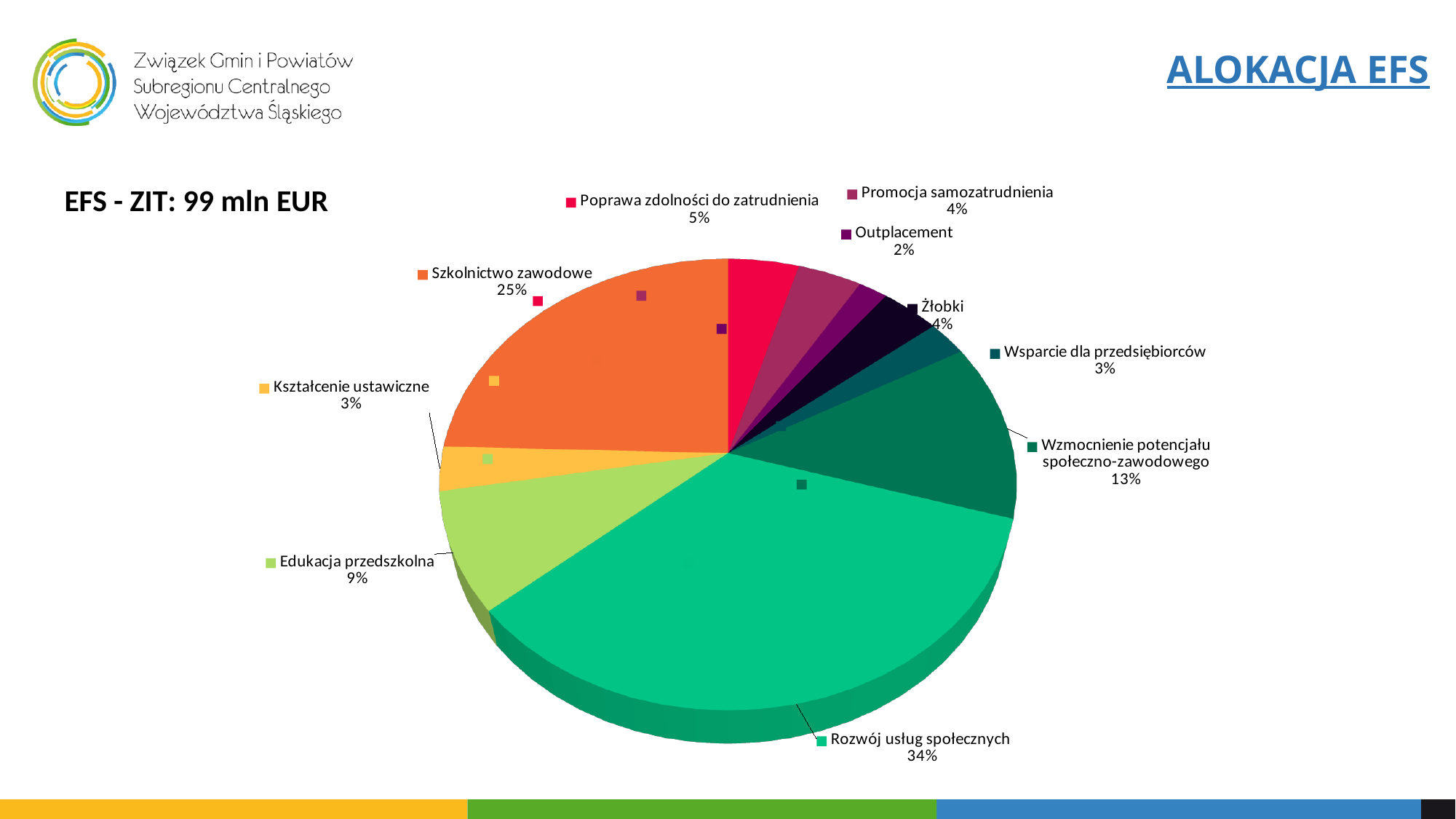
What percentage is shown for Wzmocnienie potencjału społeczno-zawodowego? 13% How many categories are shown in the pie chart? 10 What is the value shown for Edukacja przedszkolna? 9% What is the difference in percentage points between Rozwój usług społecznych and Szkolnictwo zawodowe? 9 Which category has the smallest share of the pie? Outplacement Which is larger, Edukacja przedszkolna or Poprawa zdolności do zatrudnienia? Edukacja przedszkolna What is the value shown for Szkolnictwo zawodowe? 25% What is the difference in percentage points between Wzmocnienie potencjału społeczno-zawodowego and Wsparcie dla przedsiębiorców? 10 Which category has the largest share of the pie? Rozwój usług społecznych What kind of chart is shown on the slide? Pie chart What total allocation is stated in the text next to the chart? EFS - ZIT: 99 mln EUR What share of the pie does Rozwój usług społecznych represent? 34%